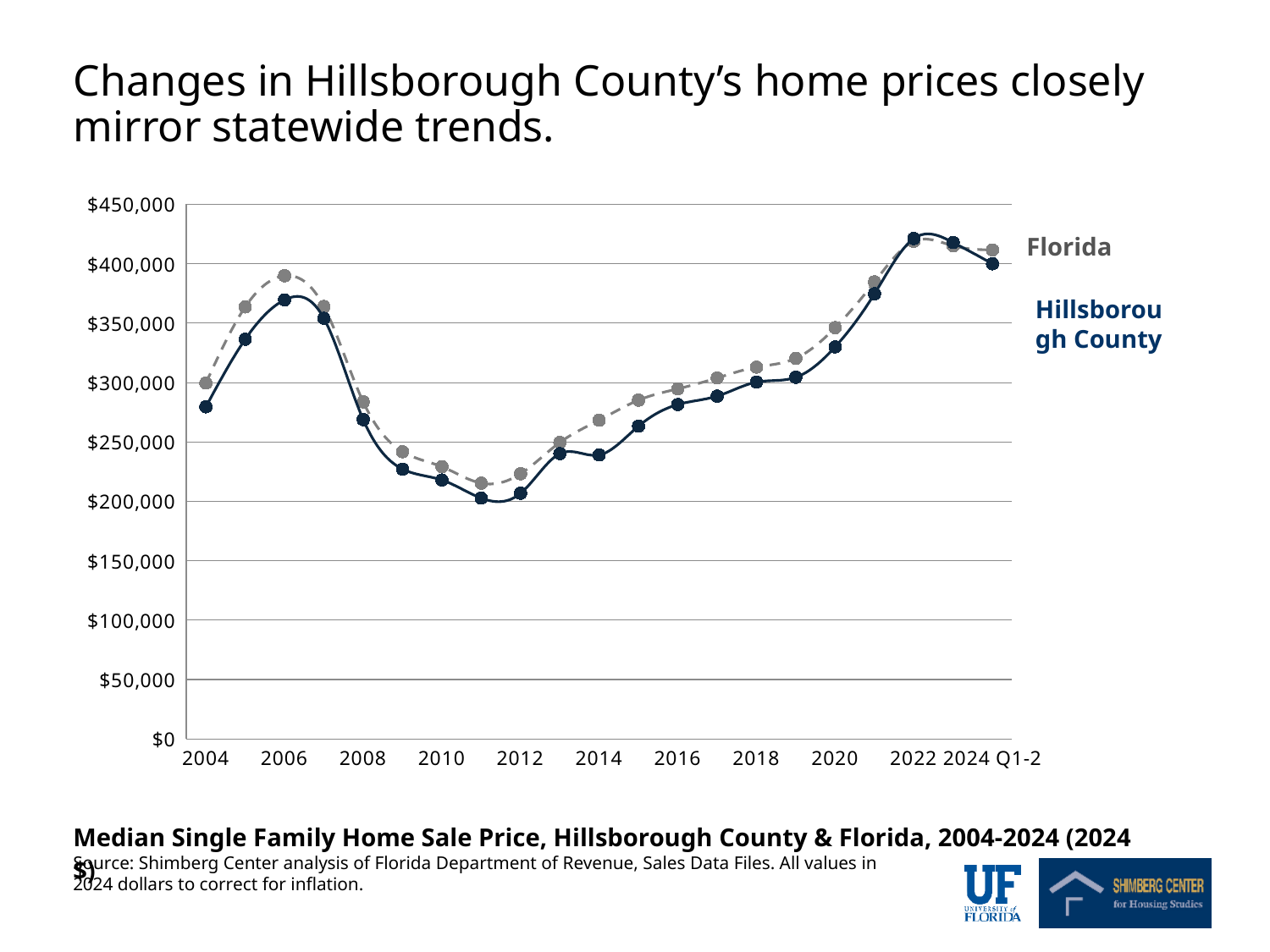
In which year does the Hillsborough County series reach its lowest value? 2011 What kind of chart is shown on the slide? Line chart In which year does the Hillsborough County series reach its highest value? 2022 Is the Hillsborough County value for 2022 greater or less than $400,000? greater Is the Hillsborough County value for 2011 greater or less than $250,000? less Is the Florida value for 2006 greater or less than $350,000? greater Which two series are plotted on the chart? Florida and Hillsborough County How many series does the chart show? 2 In 2006, which series has the higher value, Florida or Hillsborough County? Florida In which year does the Florida series reach its lowest value? 2011 What is the title of the chart? Median Single Family Home Sale Price, Hillsborough County & Florida, 2004-2024 (2024 $) Does the Hillsborough County series rise or fall between 2011 and 2022? Rise